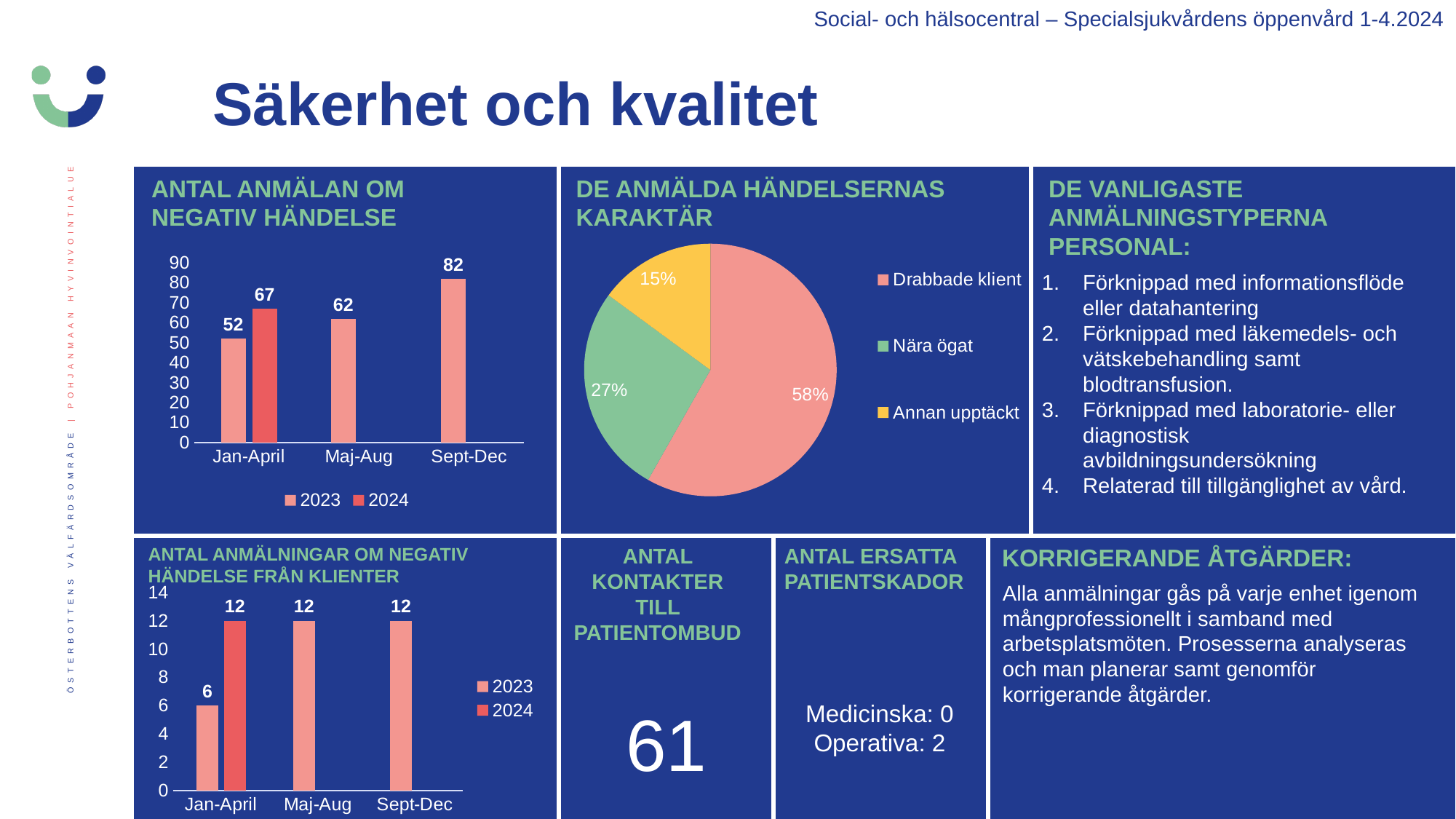
In the chart 'ANTAL ANMÄLNINGAR OM NEGATIV HÄNDELSE FRÅN KLIENTER', which is larger in Jan-April, the 2023 value or the 2024 value? 2024 In the chart 'ANTAL ANMÄLAN OM NEGATIV HÄNDELSE', what is the difference between the 2024 and 2023 values for Jan-April? 15 In the chart 'ANTAL ANMÄLAN OM NEGATIV HÄNDELSE', what is the value for 2023 in Sept-Dec? 82 In the pie chart 'DE ANMÄLDA HÄNDELSERNAS KARAKTÄR', which category has the smallest share? Annan upptäckt What kind of chart is 'DE ANMÄLDA HÄNDELSERNAS KARAKTÄR'? pie chart In the chart 'ANTAL ANMÄLAN OM NEGATIV HÄNDELSE', which period has the highest 2023 value? Sept-Dec In the chart 'ANTAL ANMÄLAN OM NEGATIV HÄNDELSE', what is the value for 2024 in Jan-April? 67 In the chart 'ANTAL ANMÄLNINGAR OM NEGATIV HÄNDELSE FRÅN KLIENTER', what is the value for 2023 in Jan-April? 6 In the chart 'ANTAL ANMÄLAN OM NEGATIV HÄNDELSE', do the 2023 values rise or fall from Jan-April to Sept-Dec? rise In the pie chart 'DE ANMÄLDA HÄNDELSERNAS KARAKTÄR', which category has the largest share? Drabbade klient In the pie chart 'DE ANMÄLDA HÄNDELSERNAS KARAKTÄR', what share is 'Nära ögat'? 27% In the chart 'ANTAL ANMÄLAN OM NEGATIV HÄNDELSE', how many series does the legend list? 2